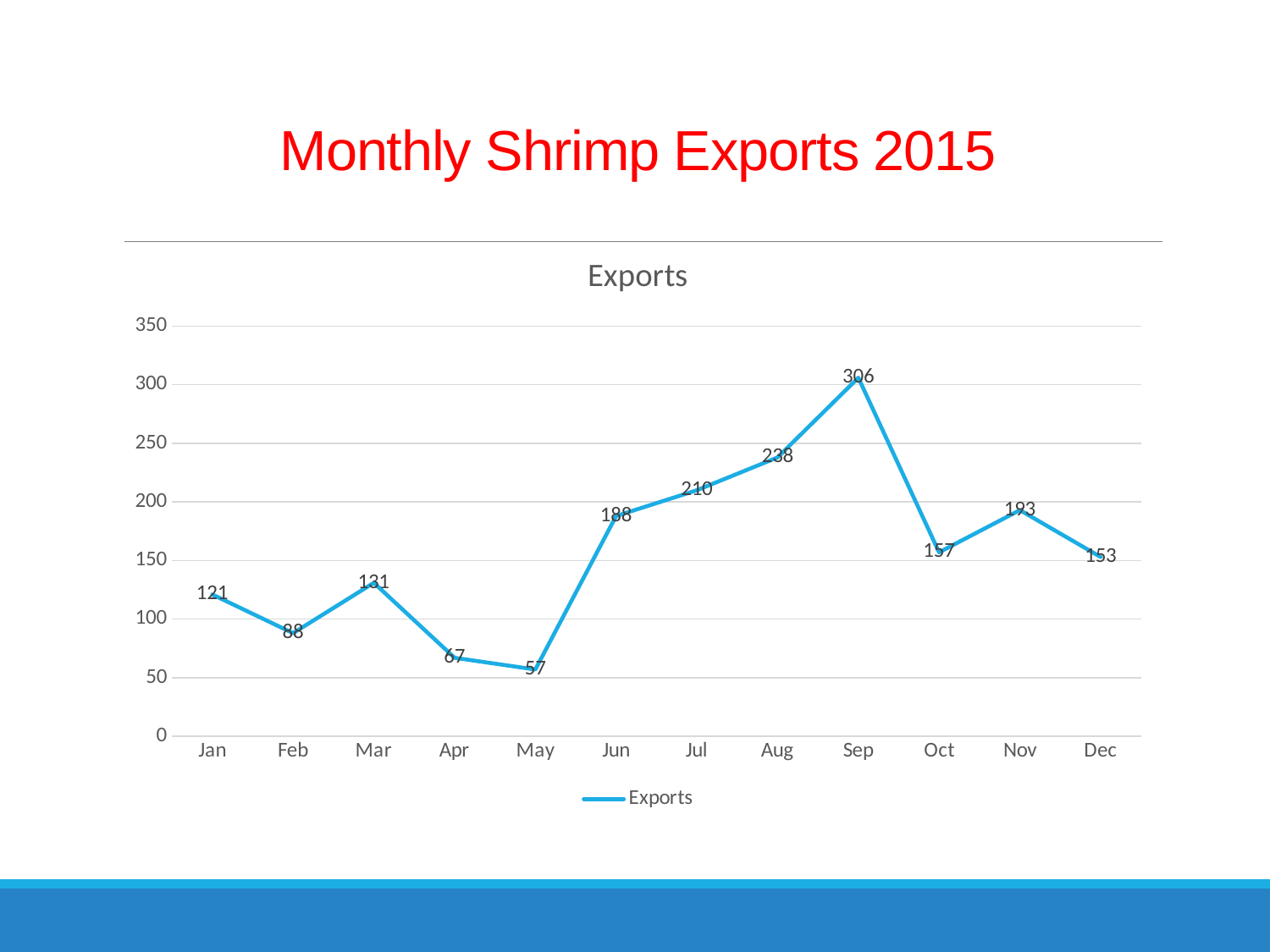
Which is larger, the value for Jul or the value for Nov? Jul What is the value for May? 57 Which month has the lowest value? May How many series does the legend list? 1 What kind of chart is shown? line chart Do the values rise or fall from May to Sep? rise Is the value for Aug greater or less than 200? greater What is the difference between the values for Sep and Oct? 149 How many months are plotted on the x axis? 12 What is the value for Sep? 306 What is the value for Jan? 121 Which month has the highest value? Sep